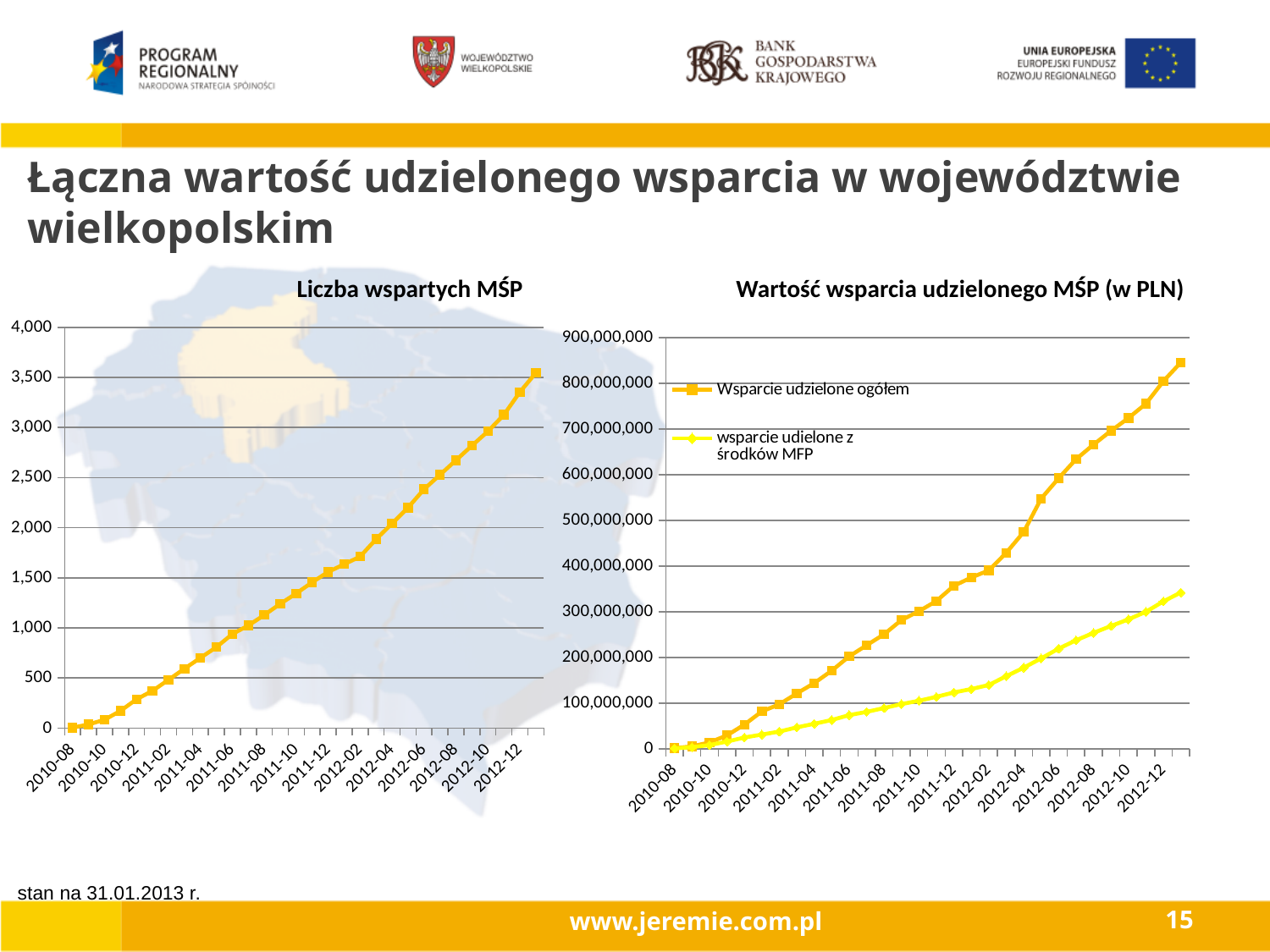
In the right chart "Wartość wsparcia udzielonego MŚP (w PLN)", do the values of "Wsparcie udzielone ogółem" rise or fall over time? rise In the left chart "Liczba wspartych MŚP", is the value for 2012-08 greater or less than 2,500? greater In the right chart "Wartość wsparcia udzielonego MŚP (w PLN)", how many series does the legend list? 2 In the right chart "Wartość wsparcia udzielonego MŚP (w PLN)", is the value of "Wsparcie udzielone ogółem" for 2012-12 greater or less than 700,000,000? greater In the left chart "Liczba wspartych MŚP", is the value for 2012-12 greater or less than 3,000? greater In the right chart "Wartość wsparcia udzielonego MŚP (w PLN)", which series has the larger value at 2012-06, "Wsparcie udzielone ogółem" or "wsparcie udielone z środków MFP"? Wsparcie udzielone ogółem What is the title of the right chart? Wartość wsparcia udzielonego MŚP (w PLN) In the left chart "Liczba wspartych MŚP", do the values rise or fall from 2010-08 to 2012-12? rise What kind of chart is the left chart titled "Liczba wspartych MŚP"? line chart